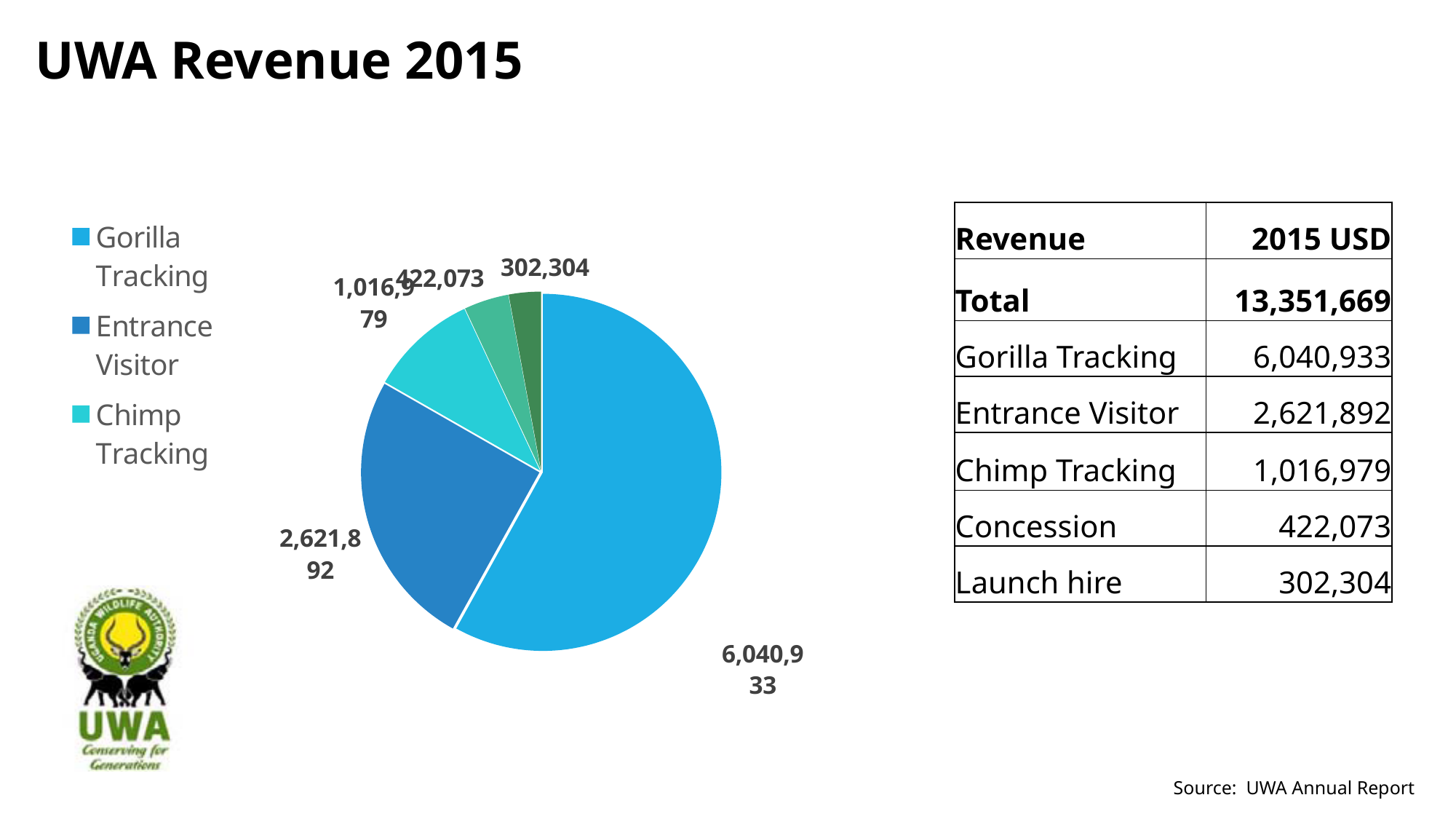
Which revenue category has the largest slice of the pie? Gorilla Tracking What is the difference between the Concession and Launch hire revenue values? 119,769 What is the 2015 revenue value for Launch hire? 302,304 How many slices does the pie chart have? 5 What is the difference between the Gorilla Tracking and Entrance Visitor revenue values? 3,419,041 Which revenue category has the smallest slice of the pie? Launch hire What is the 2015 revenue value for Entrance Visitor? 2,621,892 Which is larger, the revenue for Chimp Tracking or for Concession? Chimp Tracking What is the 2015 revenue value for Chimp Tracking? 1,016,979 How many entries does the chart legend list? 3 What is the 2015 revenue value for Gorilla Tracking? 6,040,933 What type of chart is shown on the slide? pie chart